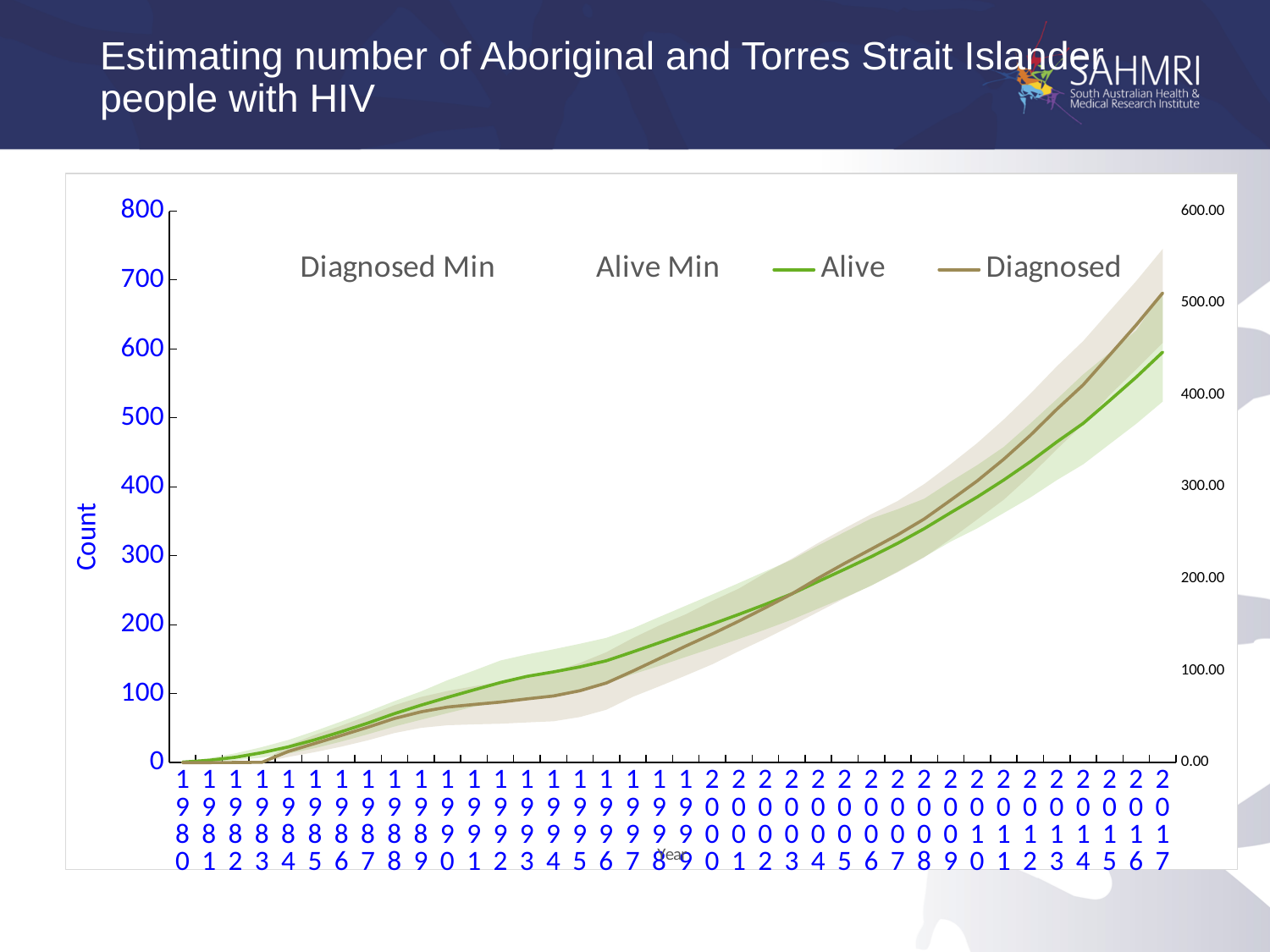
Do the Alive and Diagnosed lines rise or fall from 1980 to 2017? rise What is the highest tick value on the left vertical axis? 800 What is the last year shown on the x axis? 2017 What is the first year shown on the x axis? 1980 Which line is plotted higher at 2017, Alive or Diagnosed? Diagnosed How many years are plotted along the x axis? 38 Is the value of the Diagnosed line at 1990 greater or less than 100? less What are the four entries in the chart legend? Diagnosed Min, Alive Min, Alive, Diagnosed What is the title of the left vertical axis? Count Is the value of the Alive line at 2017 greater or less than 400? greater What kind of chart is shown on the slide? line chart How many series does the chart legend list? 4